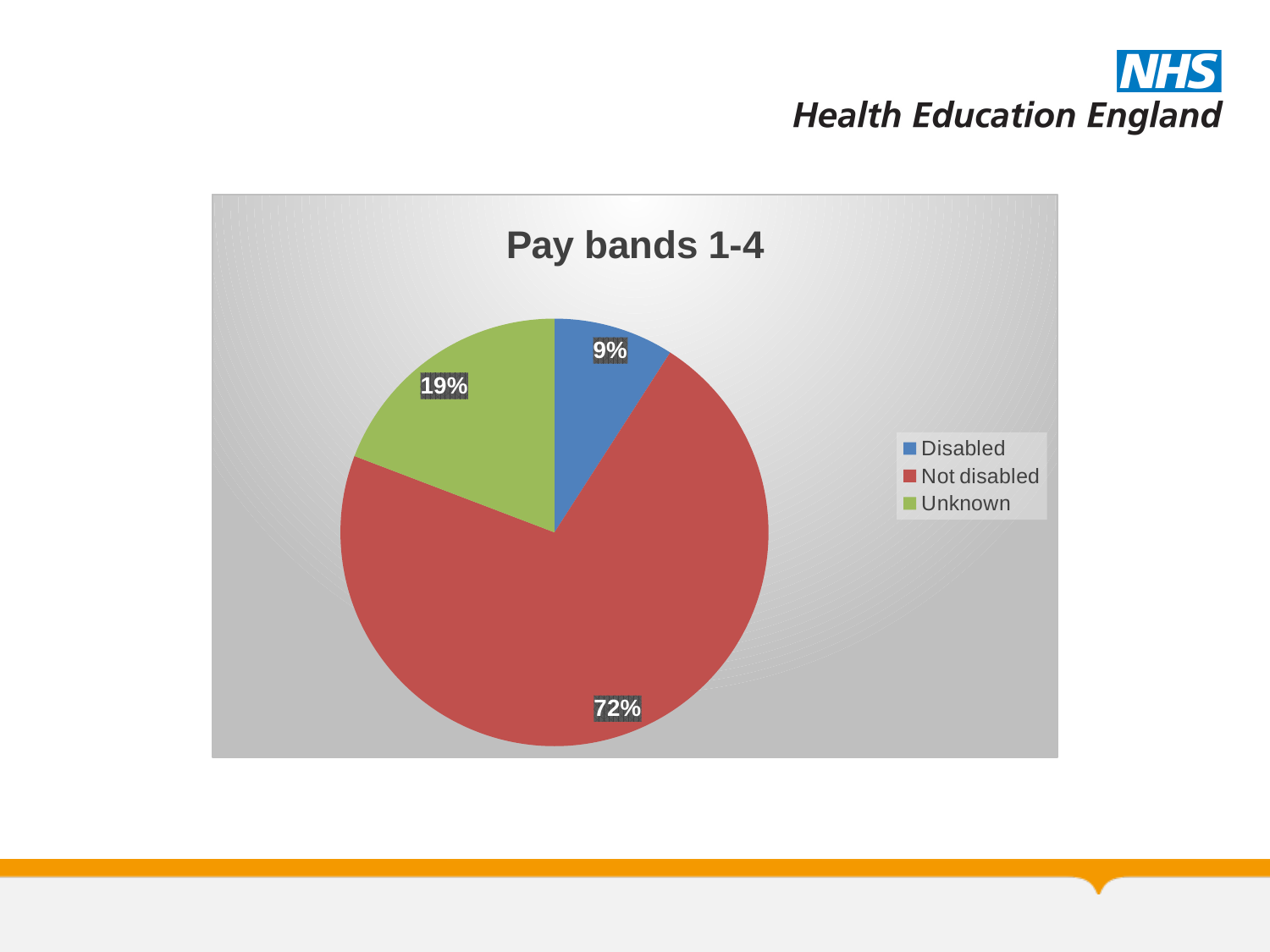
What is the title of the chart? Pay bands 1-4 What percentage of the pie is labelled Unknown? 19% Which colour represents the Unknown category in the legend? Green Which category has the largest share of the pie? Not disabled Which slice is larger, Unknown or Disabled? Unknown What percentage of the pie is labelled Not disabled? 72% What kind of chart is shown on the slide? Pie chart Which category has the smallest share of the pie? Disabled What percentage of the pie is labelled Disabled? 9% What is the difference in percentage points between the Not disabled and Unknown slices? 53 How many categories does the pie chart show? 3 What is the difference in percentage points between the Unknown and Disabled slices? 10